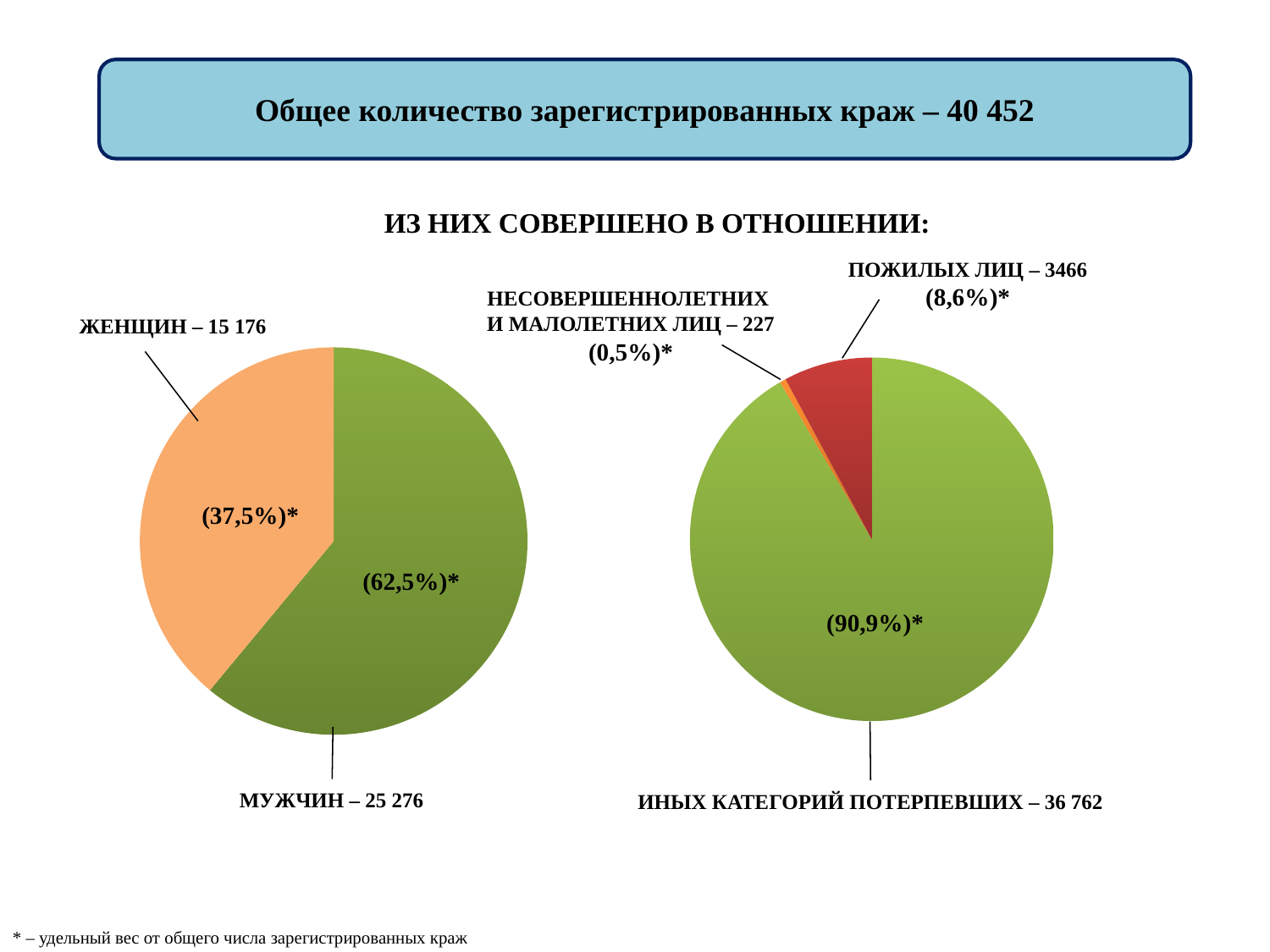
In the left pie chart, what share of the pie does the ЖЕНЩИН slice represent? 37,5% In the right pie chart, which category has the largest slice? ИНЫХ КАТЕГОРИЙ ПОТЕРПЕВШИХ In the left pie chart, what is the difference between the values for МУЖЧИН and ЖЕНЩИН? 10 100 What type of chart is the left chart on the slide? Pie chart In the left pie chart, what is the value for ЖЕНЩИН? 15 176 How many slices does the right pie chart have? 3 In the right pie chart, which category has the smallest slice? НЕСОВЕРШЕННОЛЕТНИХ И МАЛОЛЕТНИХ ЛИЦ In the left pie chart, what is the value for МУЖЧИН? 25 276 In the right pie chart, what share of the pie does the ИНЫХ КАТЕГОРИЙ ПОТЕРПЕВШИХ slice represent? 90,9% In the right pie chart, what is the value for ПОЖИЛЫХ ЛИЦ? 3466 In the left pie chart, what share of the pie does the МУЖЧИН slice represent? 62,5% In the right pie chart, what is the value for НЕСОВЕРШЕННОЛЕТНИХ И МАЛОЛЕТНИХ ЛИЦ? 227